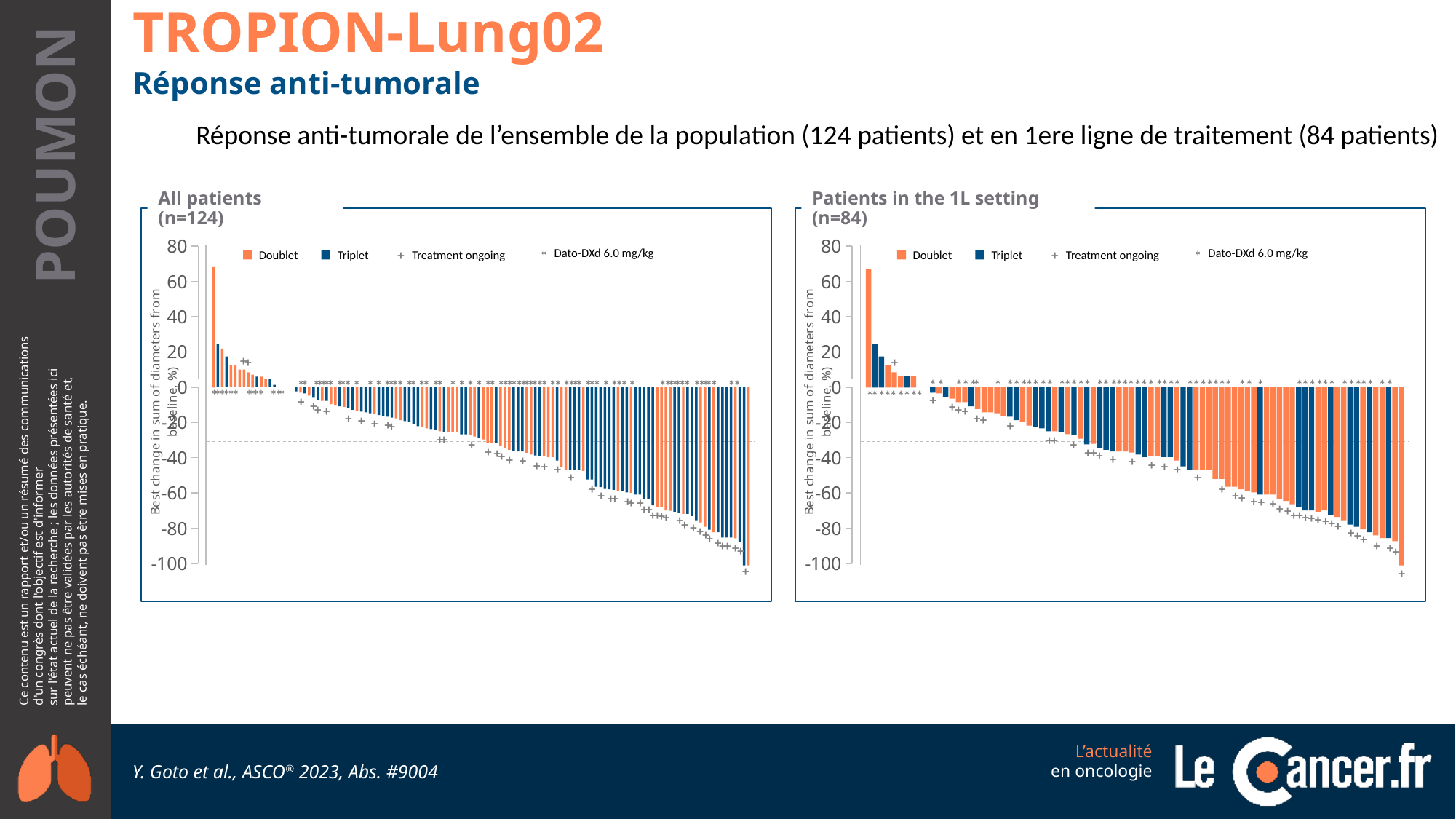
In the 'Patients in the 1L setting' chart, do the bar values rise or fall from left to right? fall In the 'Patients in the 1L setting' chart, how many patients are plotted according to the chart title? 84 In the 'All patients' chart, which treatment group is shown in orange? Doublet In the 'All patients' chart, how many patients are plotted according to the chart title? 124 In the 'All patients' chart, is the value of the lowest bar greater or less than -80? less In the 'All patients' chart, do the bar values rise or fall from left to right? fall In the 'Patients in the 1L setting' chart, which treatment group is shown in dark blue? Triplet What kind of chart is the 'All patients (n=124)' chart? bar chart What kind of chart is the 'Patients in the 1L setting (n=84)' chart? bar chart In the 'Patients in the 1L setting' chart, is the value of the tallest bar greater or less than 60? greater In the 'All patients' chart, is the value of the tallest bar greater or less than 60? greater